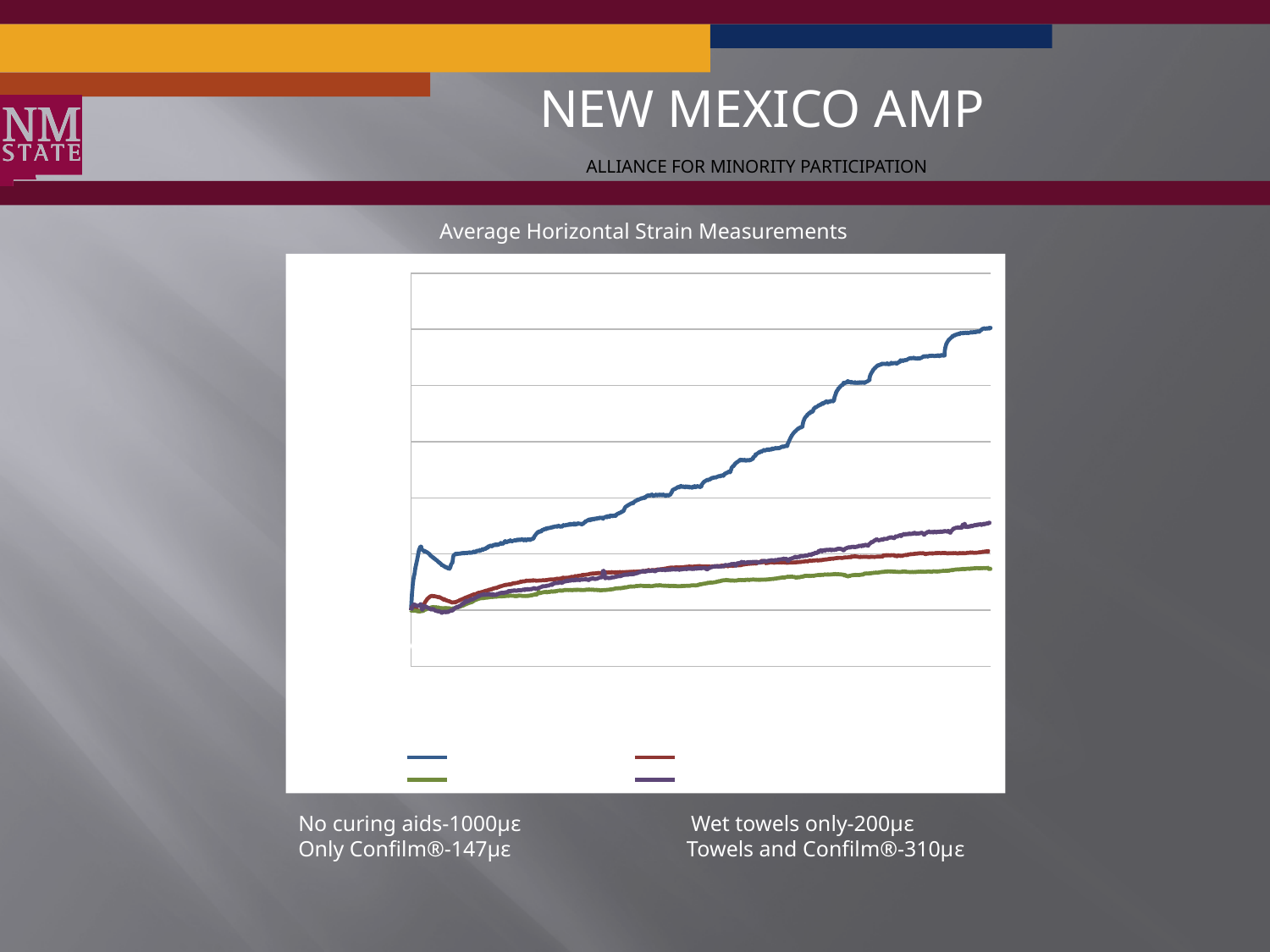
Which coloured line reaches the highest values on the chart? The blue line What is the difference between the strain values listed for No curing aids and Wet towels only? 800με Of the four curing conditions listed below the chart, which has the lowest strain value? Only Confilm® According to the text below the chart, what is the strain value for Only Confilm®? 147με Does the blue line rise or fall along the x axis? Rise According to the text below the chart, what is the strain value for Towels and Confilm®? 310με What kind of chart is shown on the slide? Line chart Which coloured line is lowest at the right end of the chart? The green line Which has the larger listed strain value, Wet towels only or Towels and Confilm®? Towels and Confilm® What is the title of the chart? Average Horizontal Strain Measurements How many series does the chart's legend list? 4 According to the text below the chart, what is the strain value for No curing aids? 1000με